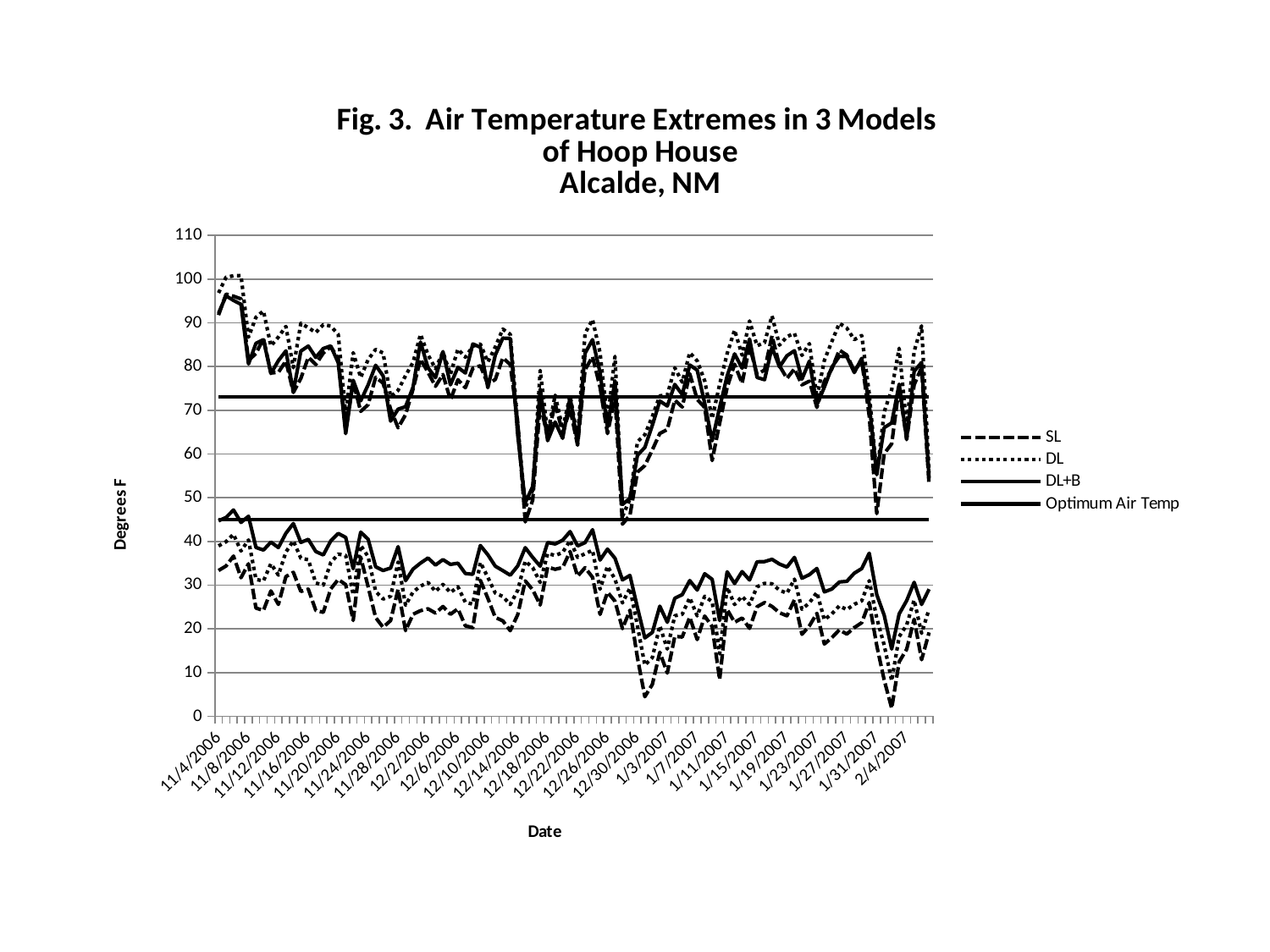
How many series does the legend list? 4 Is the first upper DL value at 11/4/2006 greater or less than 90 degrees F? greater What is the highest value shown on the vertical axis? 110 What kind of chart is shown on the slide? Line chart Is the lowest SL value near 1/31/2007 greater or less than 10 degrees F? less Is the lowest SL value near 12/30/2006 greater or less than 10 degrees F? less What is the title of the chart? Fig. 3. Air Temperature Extremes in 3 Models of Hoop House Alcalde, NM How many date labels are shown along the x axis? 24 What is the label of the vertical axis? Degrees F